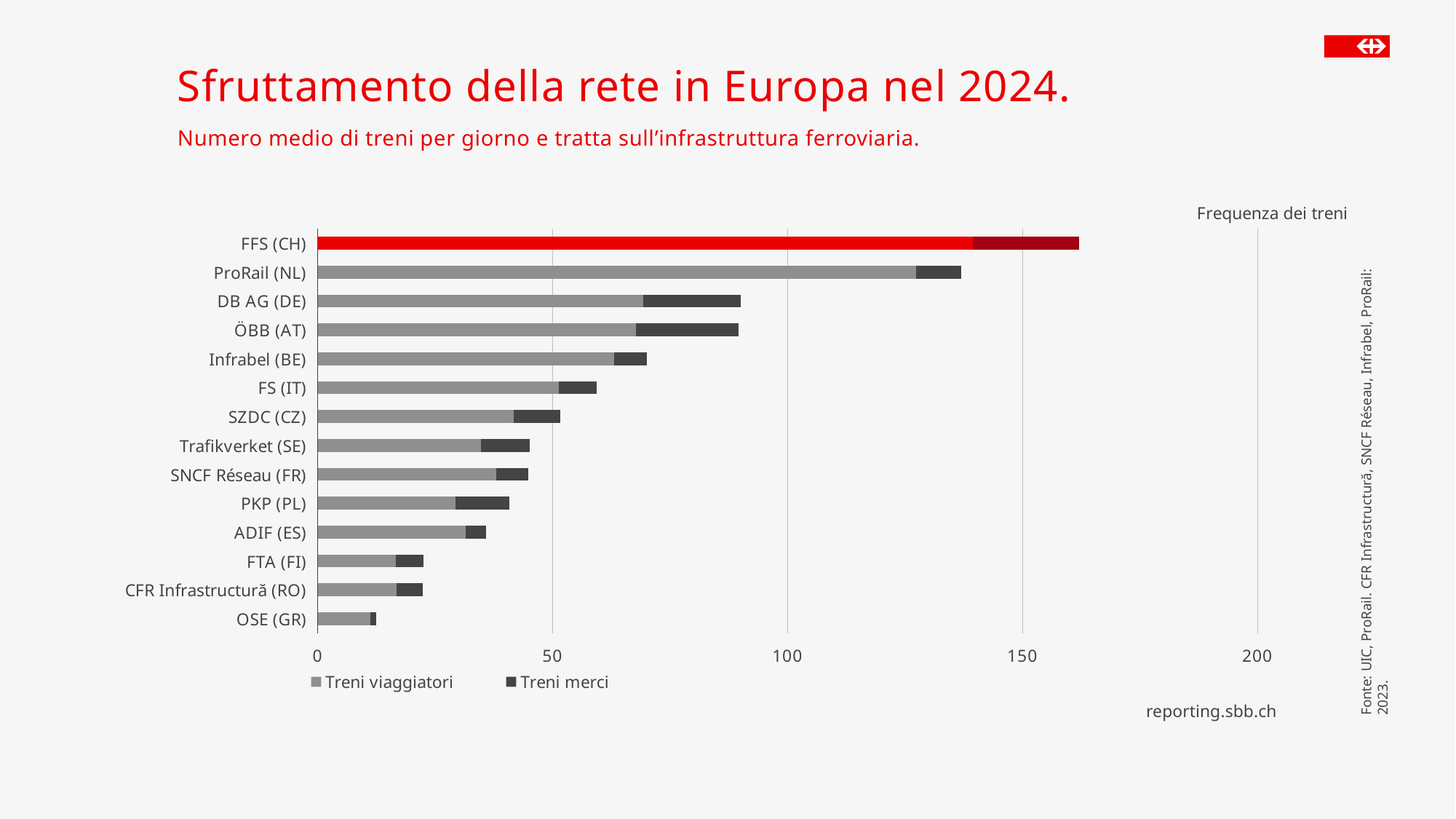
What are the two series named in the legend? Treni viaggiatori and Treni merci Which has a larger total train frequency, ProRail (NL) or DB AG (DE)? ProRail (NL) Which operator has the highest total train frequency? FFS (CH) How many railway infrastructure operators (categories) are shown in the chart? 14 Is the total value for OSE (GR) greater or less than 50? less Do the total bar lengths increase or decrease going from the top category to the bottom category? decrease What kind of chart is shown on the slide? bar chart Is the total value for ProRail (NL) greater or less than 150? less Is the total value for DB AG (DE) greater or less than 100? less Which operator has the lowest total train frequency? OSE (GR) How many series does the legend list? 2